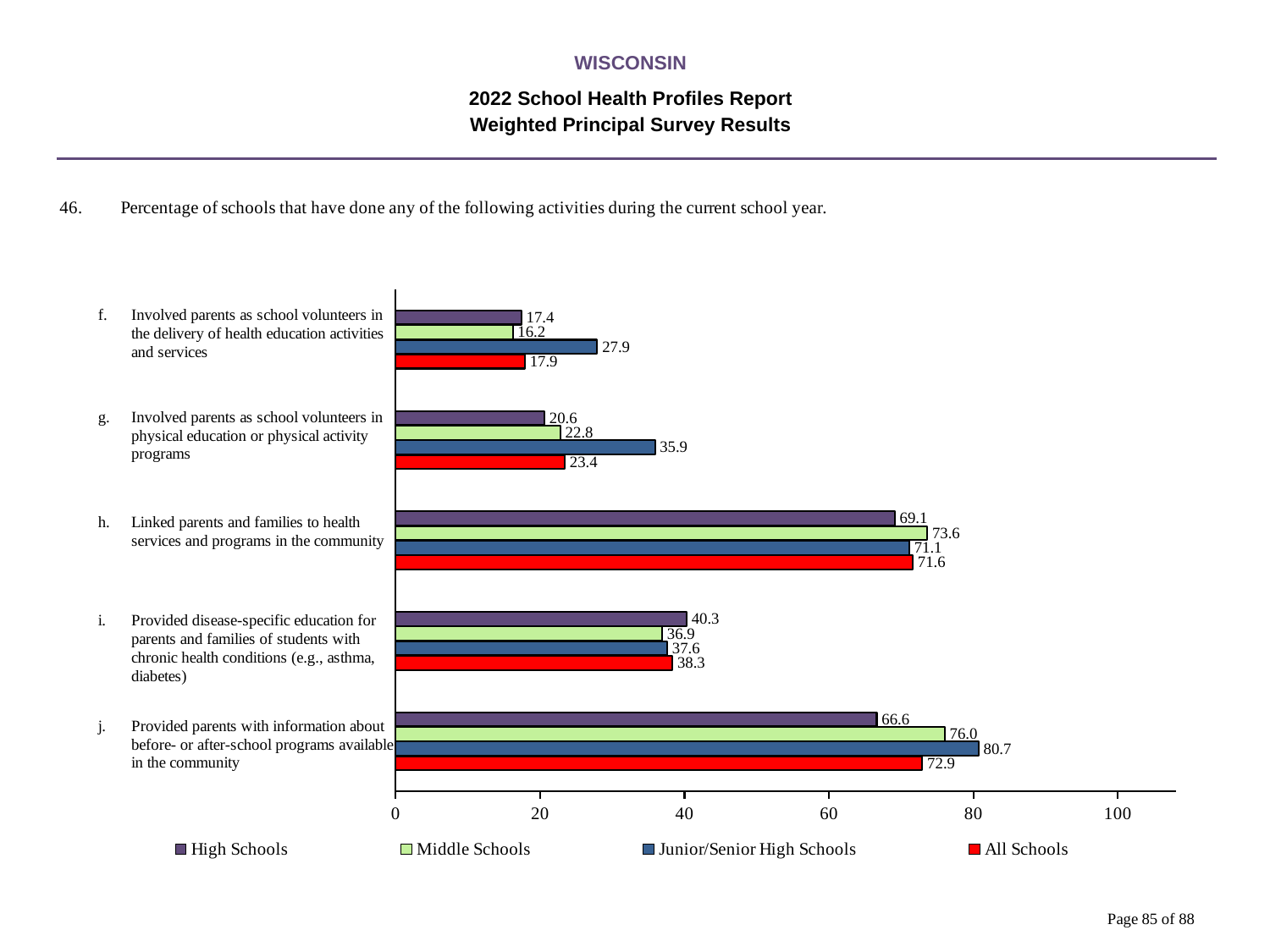
How many series does the legend list? 4 Is the All Schools value for item j greater or less than 60? greater How many activity items are plotted on the chart? 5 What kind of chart is shown on the slide? Bar chart Which colour represents All Schools in the legend? Red Which is larger for item h: the Middle Schools value or the High Schools value? Middle Schools What is the value for All Schools for item h, linking parents and families to health services and programs in the community? 71.6 Which school type has the lowest value for item i, providing disease-specific education for parents and families of students with chronic health conditions? Middle Schools What is the difference between the Junior/Senior High Schools value and the High Schools value for item j? 14.1 What is the value for Junior/Senior High Schools for item j, providing parents with information about before- or after-school programs available in the community? 80.7 Which school type has the highest value for item g, involving parents as school volunteers in physical education or physical activity programs? Junior/Senior High Schools What is the value for Middle Schools for item f, involving parents as school volunteers in the delivery of health education activities and services? 16.2